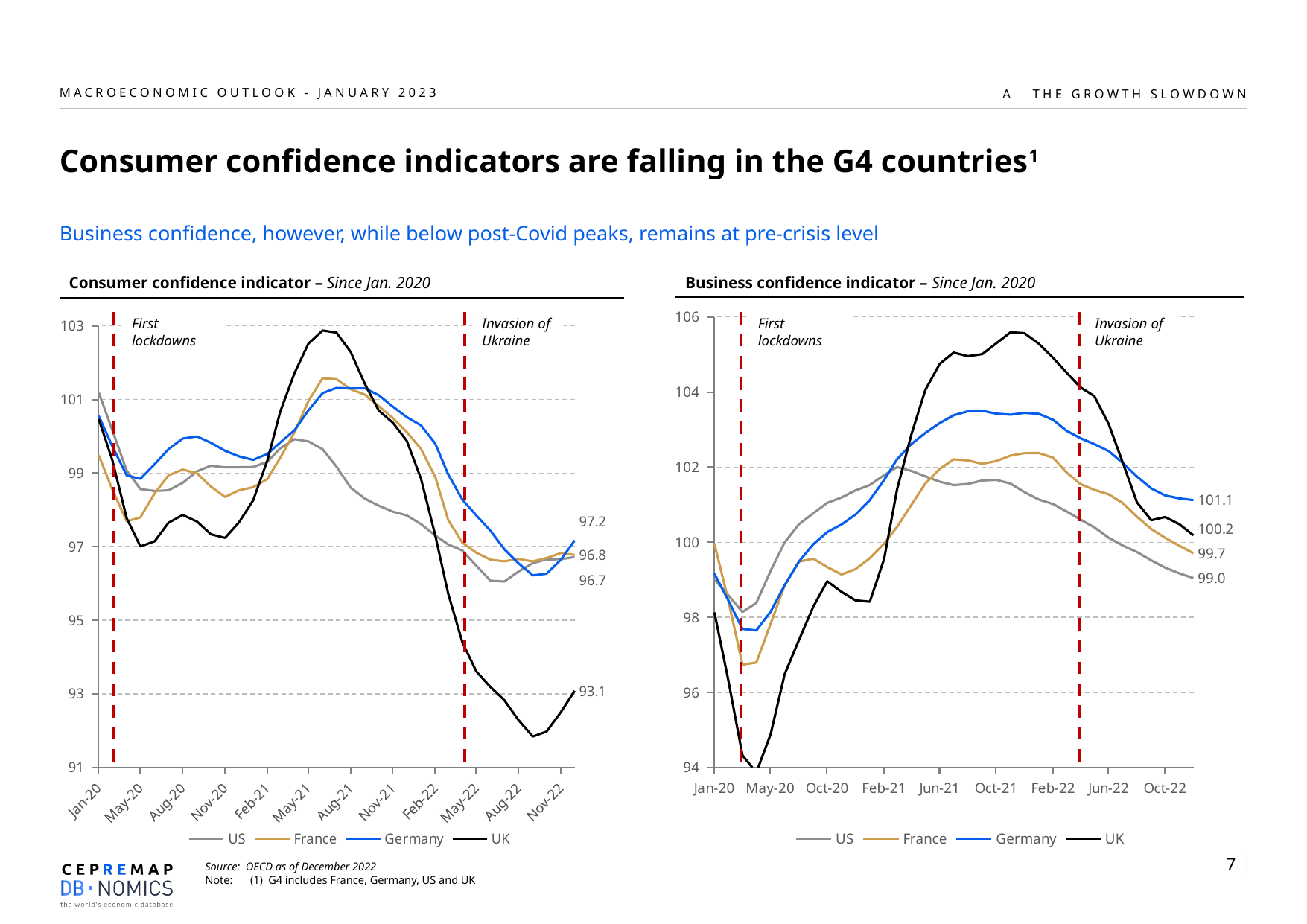
How many series does the legend of the Business confidence indicator chart list? 4 What type of chart is the Consumer confidence indicator chart? Line chart In the Consumer confidence indicator chart, which country has the lowest latest value? UK In the Consumer confidence indicator chart, what is the latest value shown for the UK? 93.1 In the Consumer confidence indicator chart, what is the latest value shown for Germany? 97.2 In the Business confidence indicator chart, what is the latest value shown for the US? 99.0 In the Business confidence indicator chart, is the latest value for the UK or for France larger? UK In the Business confidence indicator chart, what is the difference between the latest values for Germany and the US? 2.1 In the Consumer confidence indicator chart, what is the difference between the latest values for Germany and the UK? 4.1 In the Business confidence indicator chart, which country has the highest latest value? Germany In the Business confidence indicator chart, what is the latest value shown for Germany? 101.1 In the Consumer confidence indicator chart, is the UK value at the Invasion of Ukraine line greater or less than 95? less